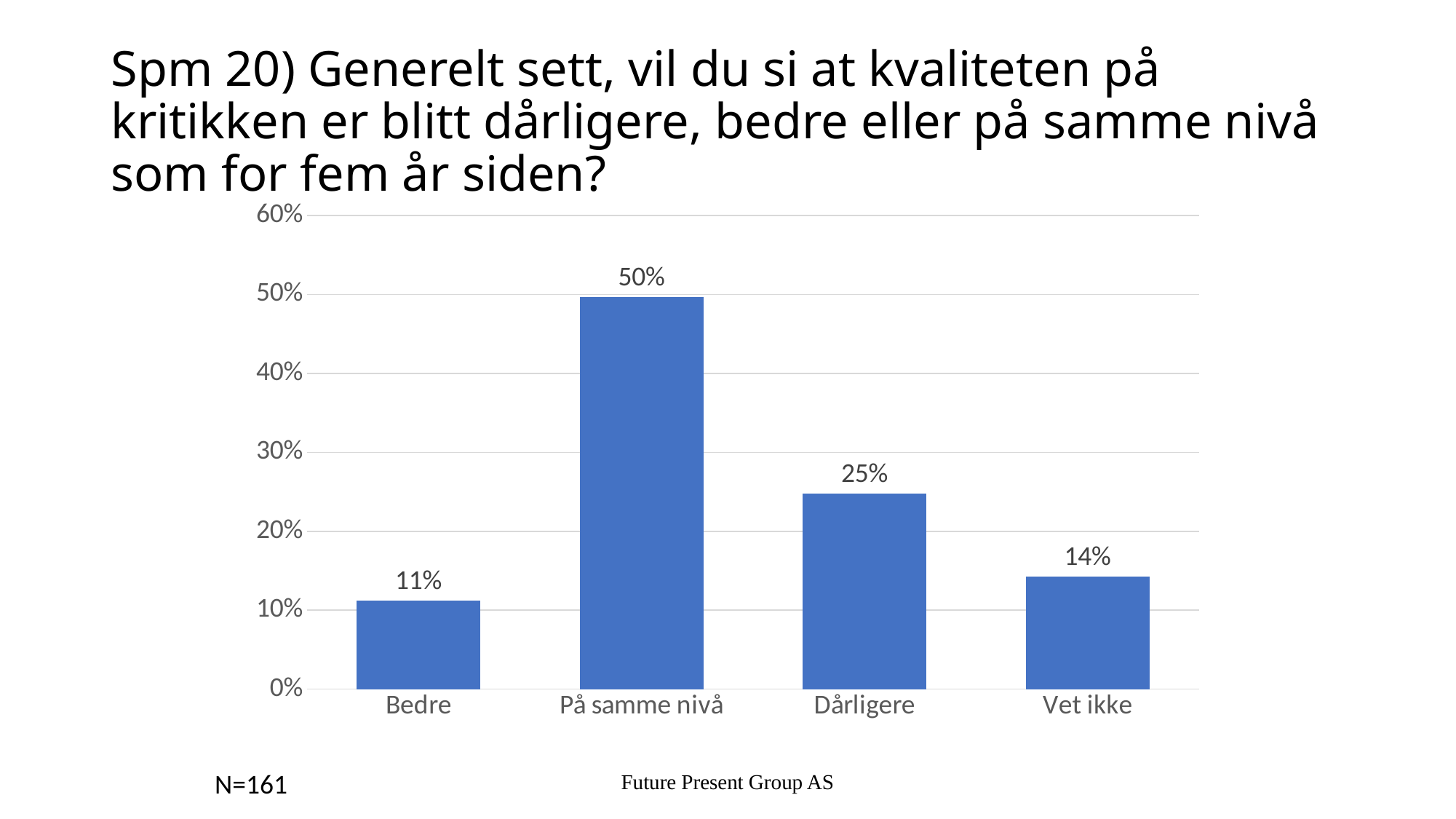
Which is larger, the value for "Dårligere" or the value for "Vet ikke"? Dårligere What is the value for "Vet ikke"? 14% What is the value for "På samme nivå"? 50% What is the difference between the values for "Vet ikke" and "Bedre"? 3% What is the difference between the values for "På samme nivå" and "Dårligere"? 25% Is the value for "Dårligere" greater or less than 20%? greater What kind of chart is shown on the slide? Bar chart Which category has the lowest value? Bedre How many categories are shown on the x axis? 4 What is the value for "Dårligere"? 25% What is the value for "Bedre"? 11% Which category has the highest value? På samme nivå